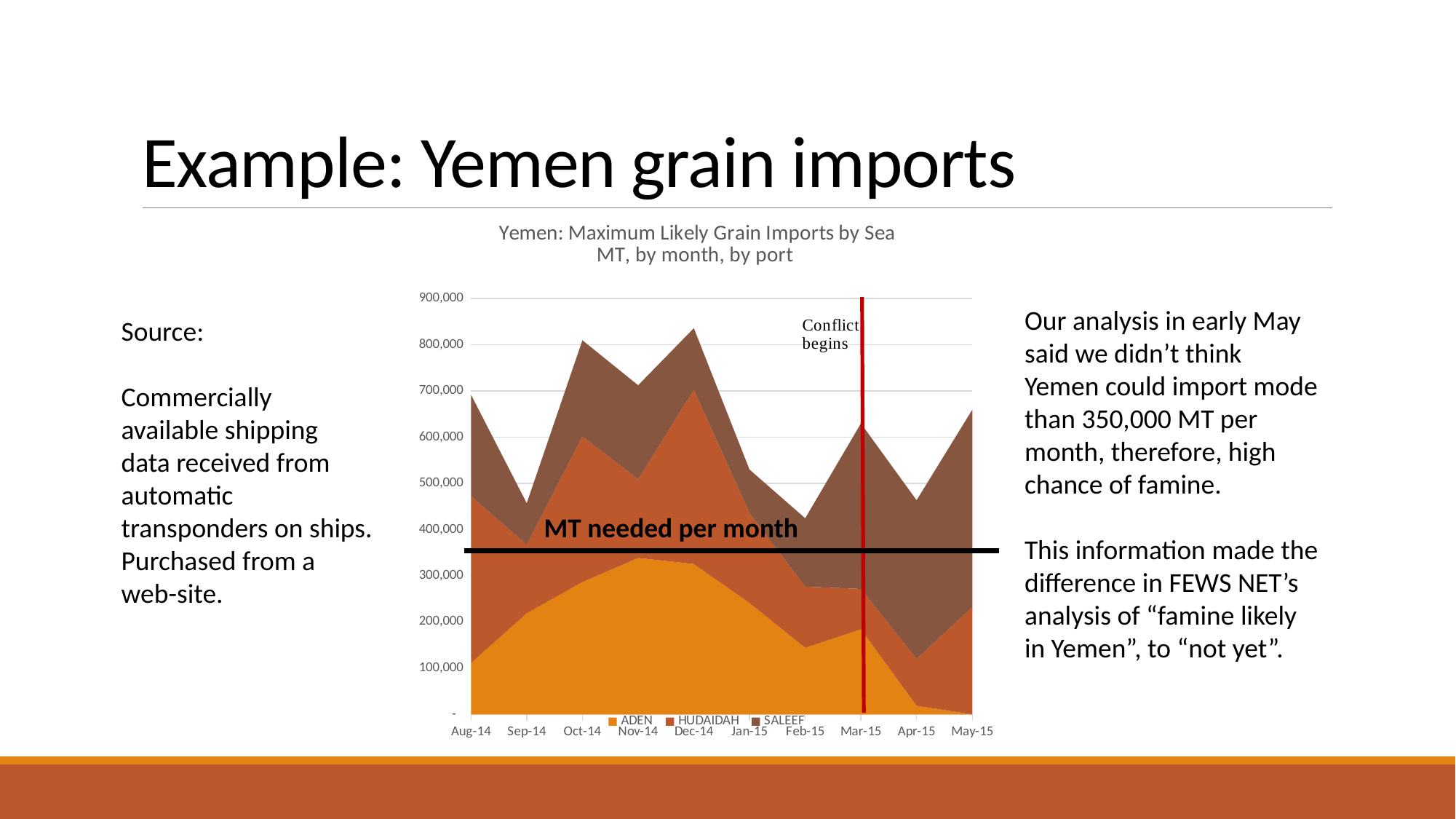
In which month is the total stacked value highest? Dec-14 What kind of chart is shown on the slide? Area chart What is the label on the horizontal black line drawn across the chart? MT needed per month How many months are plotted along the x axis of the chart? 10 Is the ADEN value for Nov-14 greater or less than 300,000? greater Is the total stacked value for Sep-14 greater or less than 500,000? less Is the ADEN value for Apr-15 greater or less than 100,000? less How many series does the chart's legend list? 3 Which month has the larger ADEN value, Aug-14 or Nov-14? Nov-14 Does the ADEN value rise or fall from Nov-14 to May-15? Fall Which ports are listed in the chart's legend? ADEN, HUDAIDAH, SALEEF